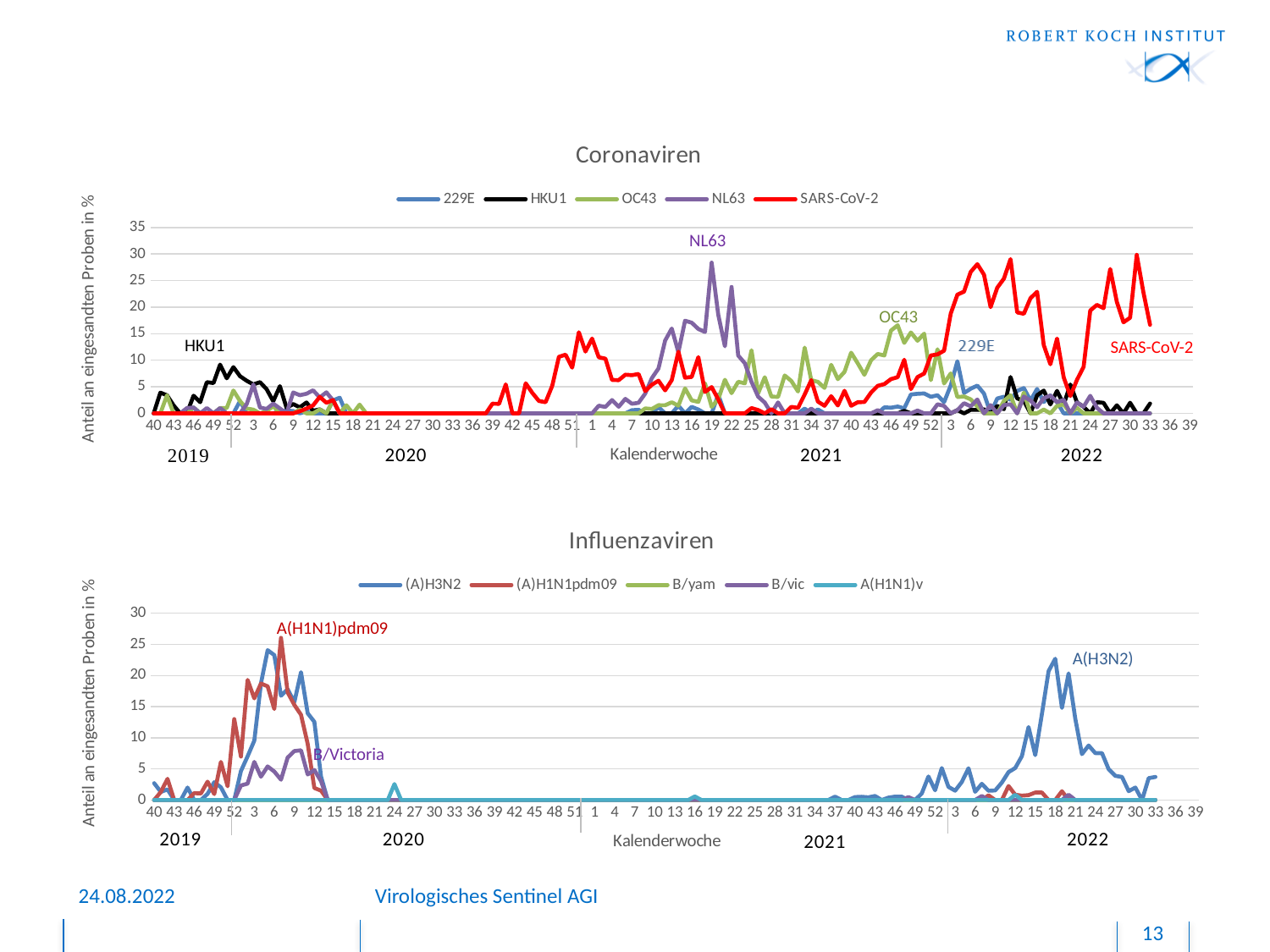
What is the y-axis label of the Coronaviren chart? Anteil an eingesandten Proben in % What kind of chart is the Coronaviren chart? line chart In the Influenzaviren chart, does the A(H3N2) line rise or fall between week 18 and week 30 of 2022? fall How many series does the legend of the Influenzaviren chart list? 5 In the Coronaviren chart, is the peak value of the NL63 line greater or less than 20? greater In the Influenzaviren chart, is the peak value of the B/Victoria line greater or less than 10? less How many series does the legend of the Coronaviren chart list? 5 In the Coronaviren chart, is the peak value of the OC43 line greater or less than 10? greater In the Influenzaviren chart, which line reaches a higher peak, A(H1N1)pdm09 or B/Victoria? A(H1N1)pdm09 In the Coronaviren chart, which line reaches a higher peak, OC43 or HKU1? OC43